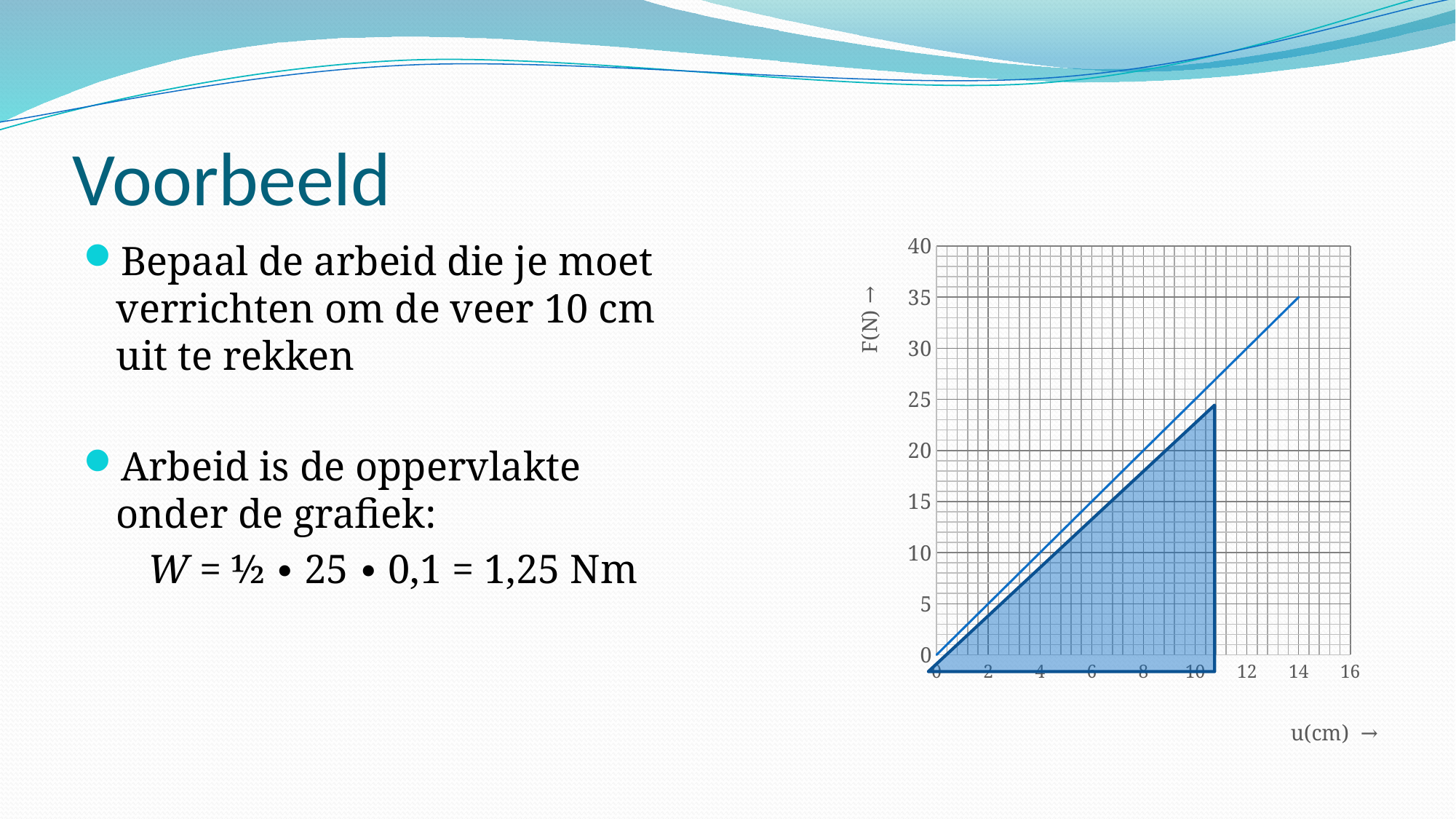
Is the value of F at u = 4 cm greater or less than 15 N? less Is the value of F at u = 8 cm greater or less than 15 N? greater Is the value of F at u = 14 cm greater or less than 30 N? greater Does the force F rise or fall as the extension u increases along the x axis? rises Which is larger, the force at u = 6 cm or the force at u = 12 cm? u = 12 cm What kind of chart is shown on the slide? line chart What is the label of the horizontal axis of the chart? u(cm) What is the label of the vertical axis of the chart? F(N) Up to which extension u does the shaded area under the graph extend? 10 cm